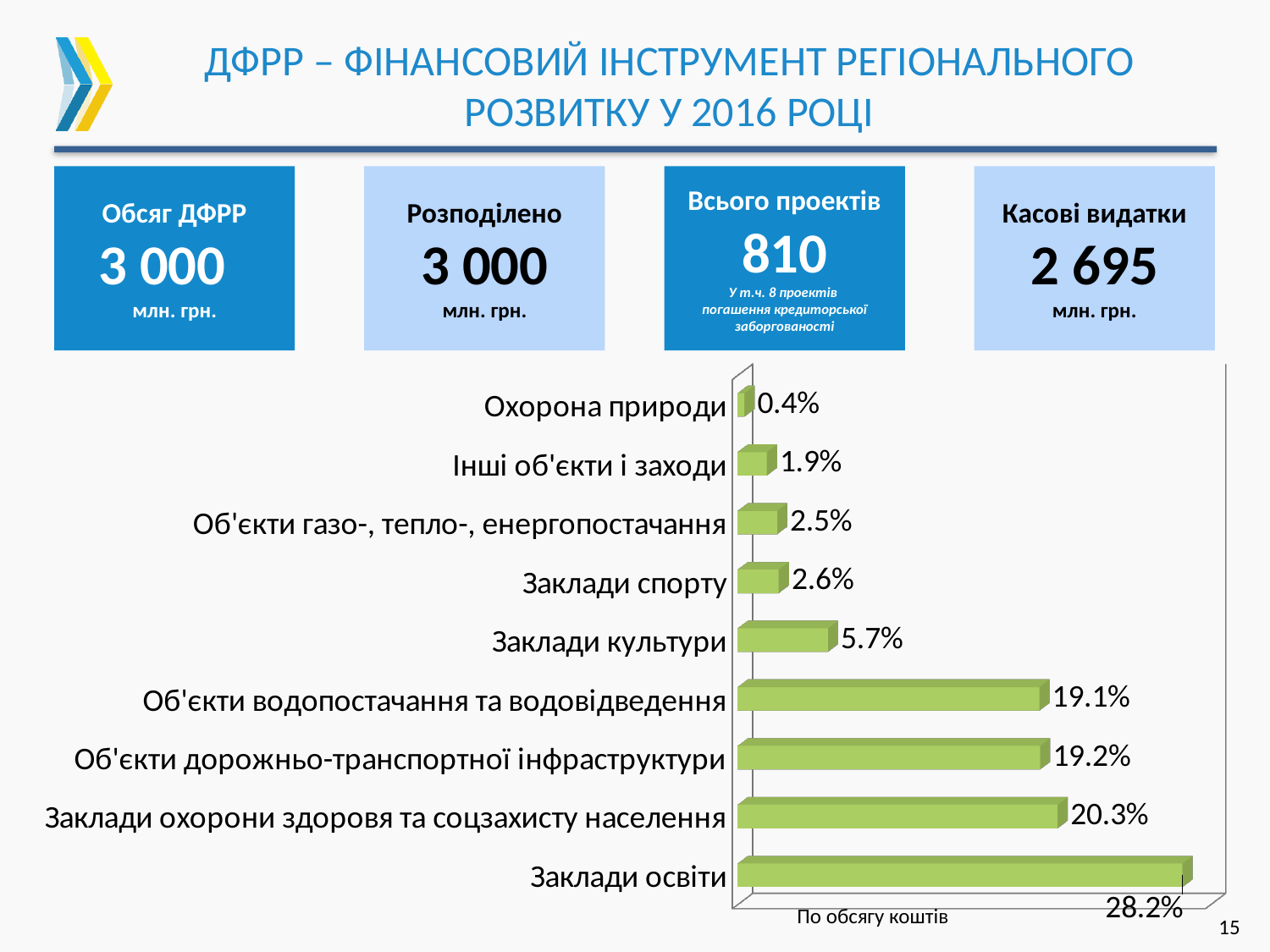
Which category has the lowest value? Охорона природи What is the value for Заклади освіти? 28.2% What kind of chart is shown on the slide? Bar chart What is the value for Заклади культури? 5.7% What is the difference between Заклади освіти and Заклади охорони здоровя та соцзахисту населення? 7.9% What is the axis label shown below the chart? По обсягу коштів Which category has the highest value? Заклади освіти Which is larger: Заклади спорту or Заклади культури? Заклади культури What is the value for Об'єкти водопостачання та водовідведення? 19.1% What is the value for Охорона природи? 0.4% How many categories are shown in the chart? 9 What is the difference between Інші об'єкти і заходи and Об'єкти газо-, тепло-, енергопостачання? 0.6%